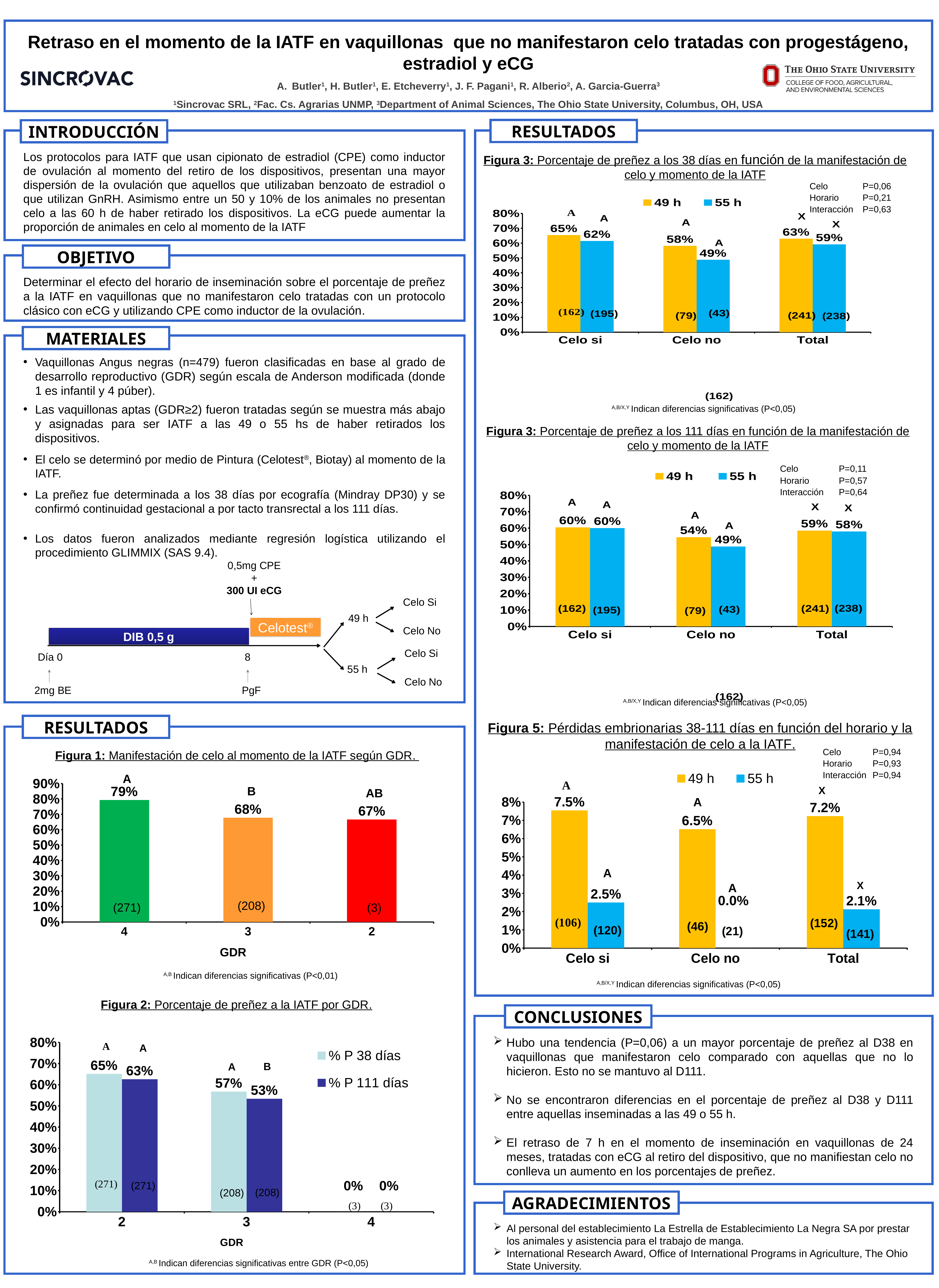
In Figura 1 (Manifestación de celo al momento de la IATF según GDR), which GDR category has the highest value? 4 In the Figura 3 chart for preñez a los 38 días, what is the 55 h value for Celo no? 49% In the Figura 3 chart for preñez a los 38 días, which is larger for Celo si: the 49 h value or the 55 h value? 49 h In Figura 1 (Manifestación de celo al momento de la IATF según GDR), what is the value for GDR 4? 79% In the Figura 3 chart for preñez a los 111 días, what is the 49 h value for Total? 59% In Figura 1 (Manifestación de celo al momento de la IATF según GDR), what is the difference between the values for GDR 4 and GDR 3? 11% In Figura 2 (Porcentaje de preñez a la IATF por GDR), what kind of chart is shown? Bar chart In Figura 2 (Porcentaje de preñez a la IATF por GDR), how many series does the legend list? 2 In Figura 2 (Porcentaje de preñez a la IATF por GDR), what is the % P 111 días value for GDR 3? 53% In Figura 5 (Pérdidas embrionarias 38-111 días), how many categories are shown on the x axis? 3 In Figura 5 (Pérdidas embrionarias 38-111 días), what is the 55 h value for Celo no? 0.0% In the Figura 3 chart for preñez a los 38 días, what is the difference between the 49 h and 55 h values for Celo no? 9%